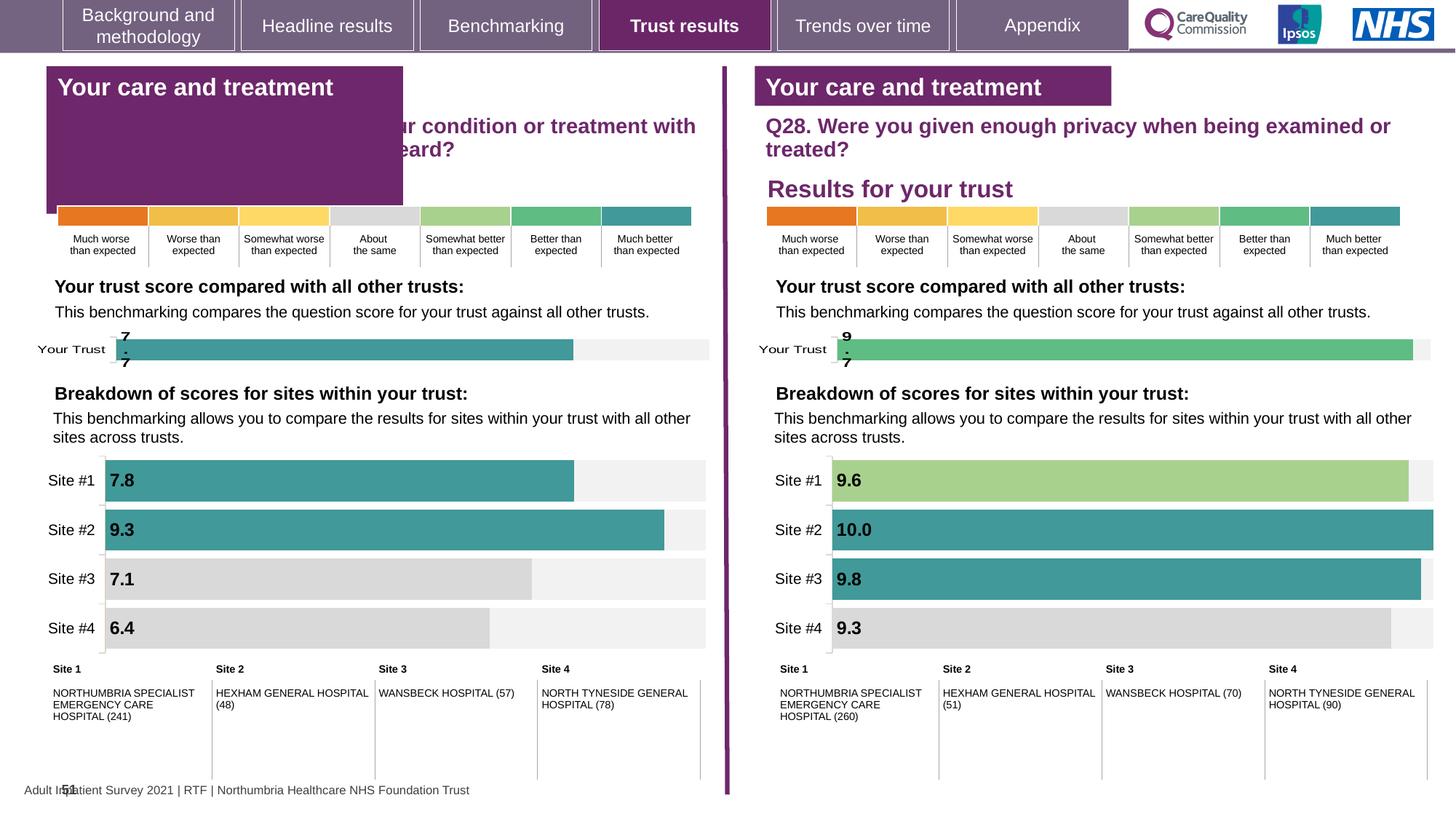
In the right-hand chart (Q28, breakdown of scores for sites within your trust), what is the score for Site #2? 10.0 In the right-hand site breakdown chart (Q28), what is the difference between the scores for Site #3 and Site #1? 0.2 How many sites are shown in the left-hand site breakdown chart? 4 In the left-hand site breakdown chart, which has the higher score, Site #1 or Site #3? Site #1 In the right-hand site breakdown chart (Q28), which has the higher score, Site #2 or Site #4? Site #2 In the left-hand 'Your trust score compared with all other trusts' chart, what is the score for Your Trust? 7.7 In the left-hand site breakdown chart, which site has the highest score? Site #2 In the right-hand site breakdown chart (Q28), which site has the lowest score? Site #4 In the left-hand chart (breakdown of scores for sites within your trust), what is the score for Site #4? 6.4 In the left-hand site breakdown chart, what is the difference between the scores for Site #2 and Site #4? 2.9 In the right-hand 'Your trust score compared with all other trusts' chart (Q28), what is the score for Your Trust? 9.7 What type of chart is used for the breakdown of scores for sites within your trust on the right-hand side (Q28)? Bar chart